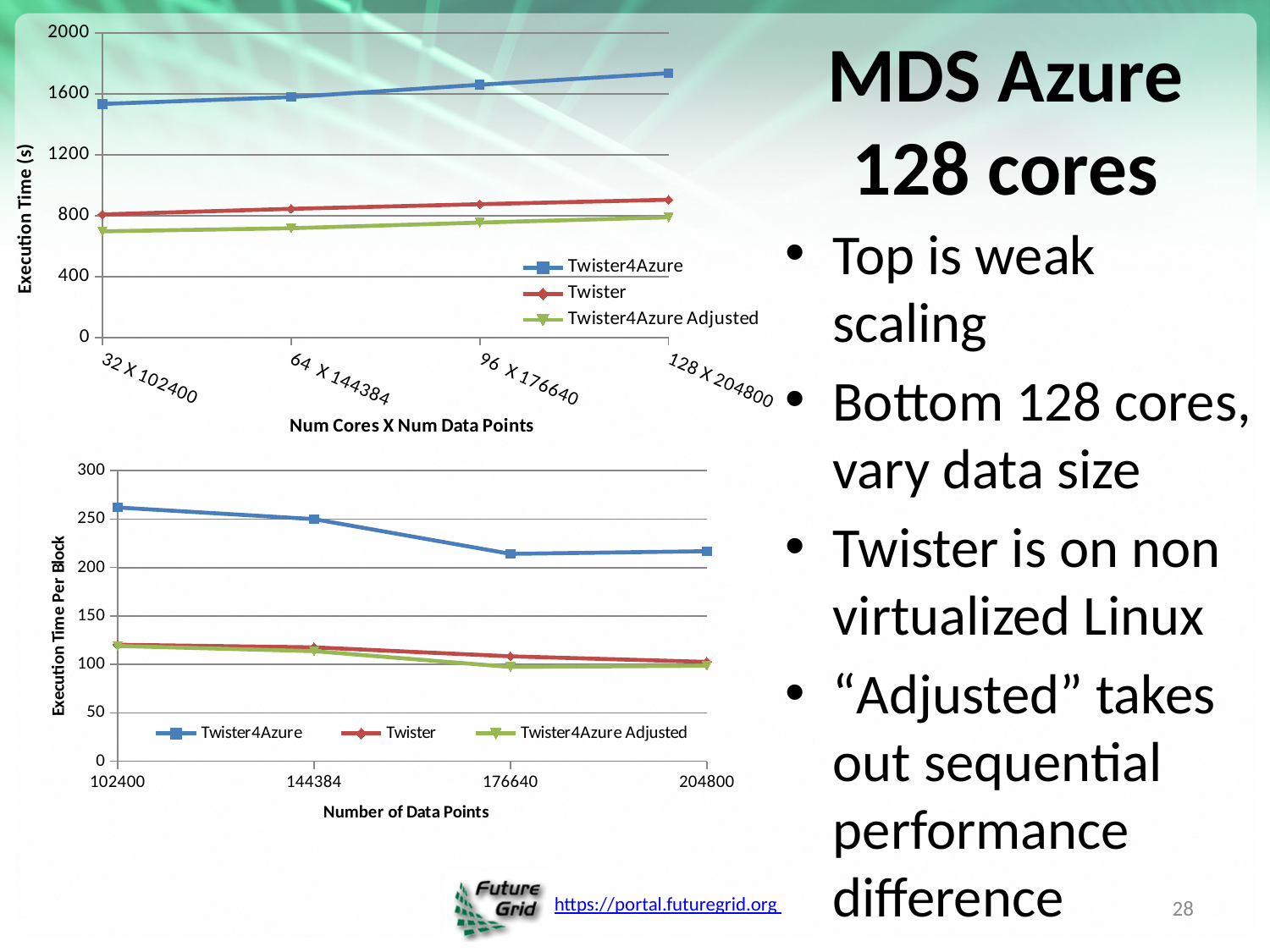
In the bottom chart, which is larger at 204800 data points: Twister4Azure or Twister? Twister4Azure What kind of chart is the top chart on the slide? line chart What is the x-axis title of the bottom chart? Number of Data Points In the top chart, does the Twister4Azure line rise or fall from 32 X 102400 to 128 X 204800? rise In the top chart, which series has the lowest execution time at 32 X 102400? Twister4Azure Adjusted In the top chart, is the Twister4Azure value at 128 X 204800 greater or less than 1600? greater In the top chart, is the Twister value at 32 X 102400 greater or less than 1200? less How many categories are shown on the x axis of the top chart? 4 How many series does the legend of the top chart list? 3 In the bottom chart, does the Twister4Azure line rise or fall from 102400 to 176640 data points? fall In the top chart, which series has the highest execution time at 96 X 176640? Twister4Azure In the bottom chart, is the Twister4Azure value at 102400 data points greater or less than 250? greater